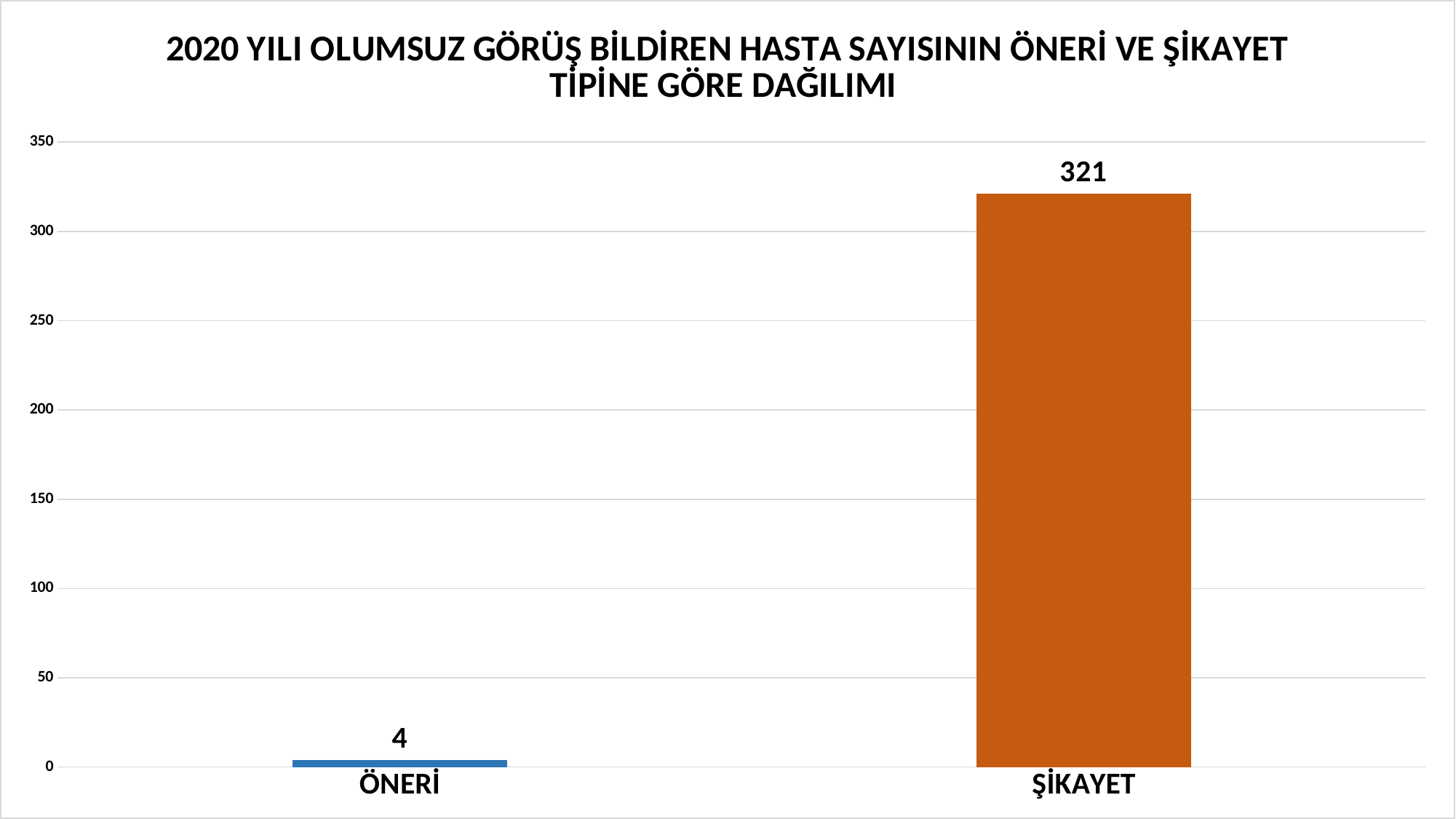
Which category has the lowest value? ÖNERİ How many categories are shown on the chart? 2 Which category has the highest value? ŞİKAYET What is the title of the chart? 2020 YILI OLUMSUZ GÖRÜŞ BİLDİREN HASTA SAYISININ ÖNERİ VE ŞİKAYET TİPİNE GÖRE DAĞILIMI What is the difference between the values for ŞİKAYET and ÖNERİ? 317 Is the value for ÖNERİ greater or less than 50? less Is the value for ŞİKAYET greater or less than 300? greater Which is larger, the value for ÖNERİ or the value for ŞİKAYET? ŞİKAYET What kind of chart is shown on the slide? bar chart What is the value for ŞİKAYET? 321 What colour is the bar for ŞİKAYET? orange What is the value for ÖNERİ? 4